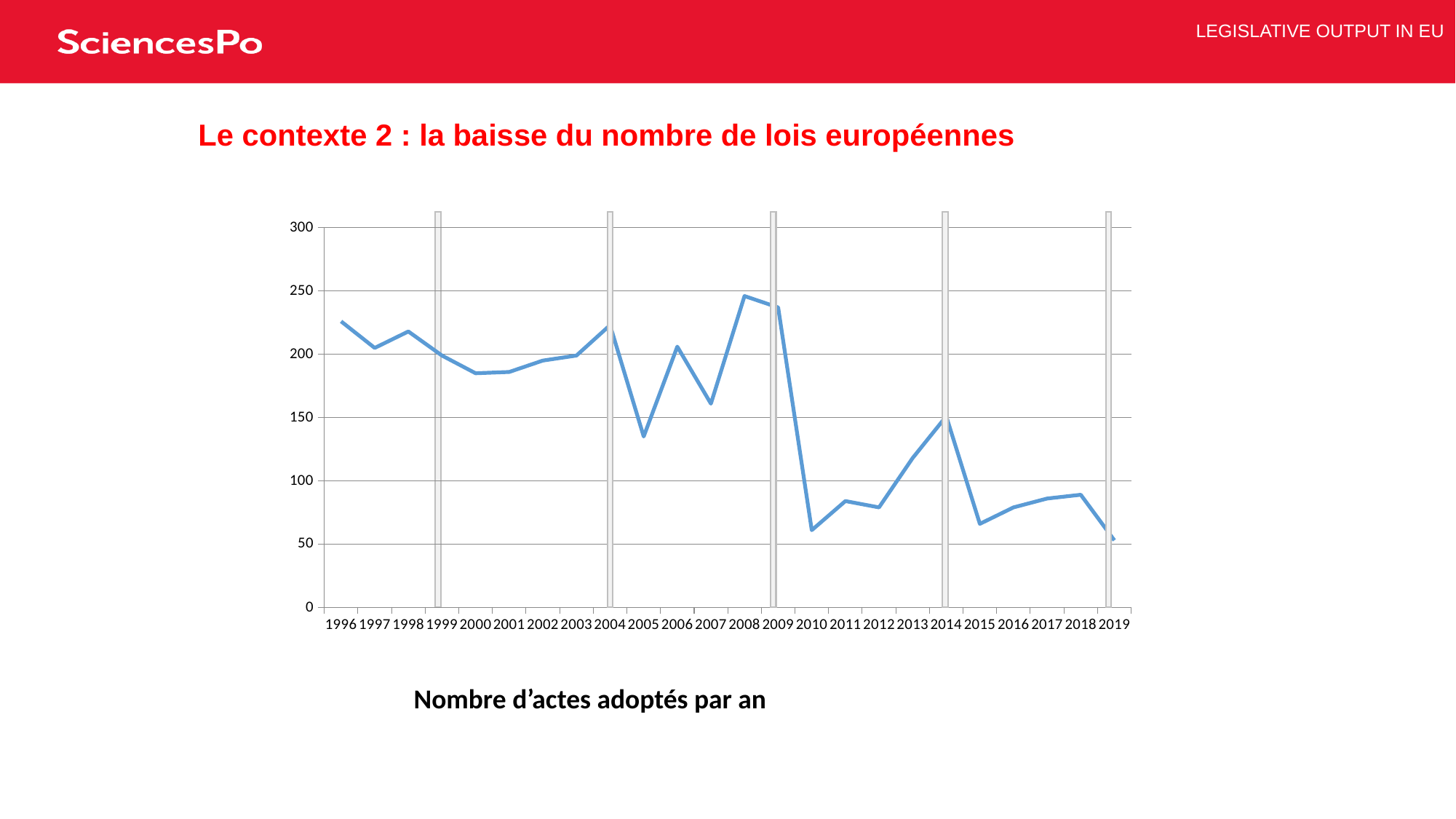
Is the value for 2005 greater or less than 150? less Which year has the highest number of acts adopted in the chart? 2008 How many years are plotted along the x axis of the chart? 24 Is the value for 1996 greater or less than 200? greater Is the value for 2008 greater or less than 200? greater Overall, do the values rise or fall from 1996 to 2019? fall What is the caption given below the chart? Nombre d’actes adoptés par an Which year has the larger value, 2009 or 2010? 2009 What kind of chart is shown on the slide? line chart Which year has the larger value, 2004 or 2005? 2004